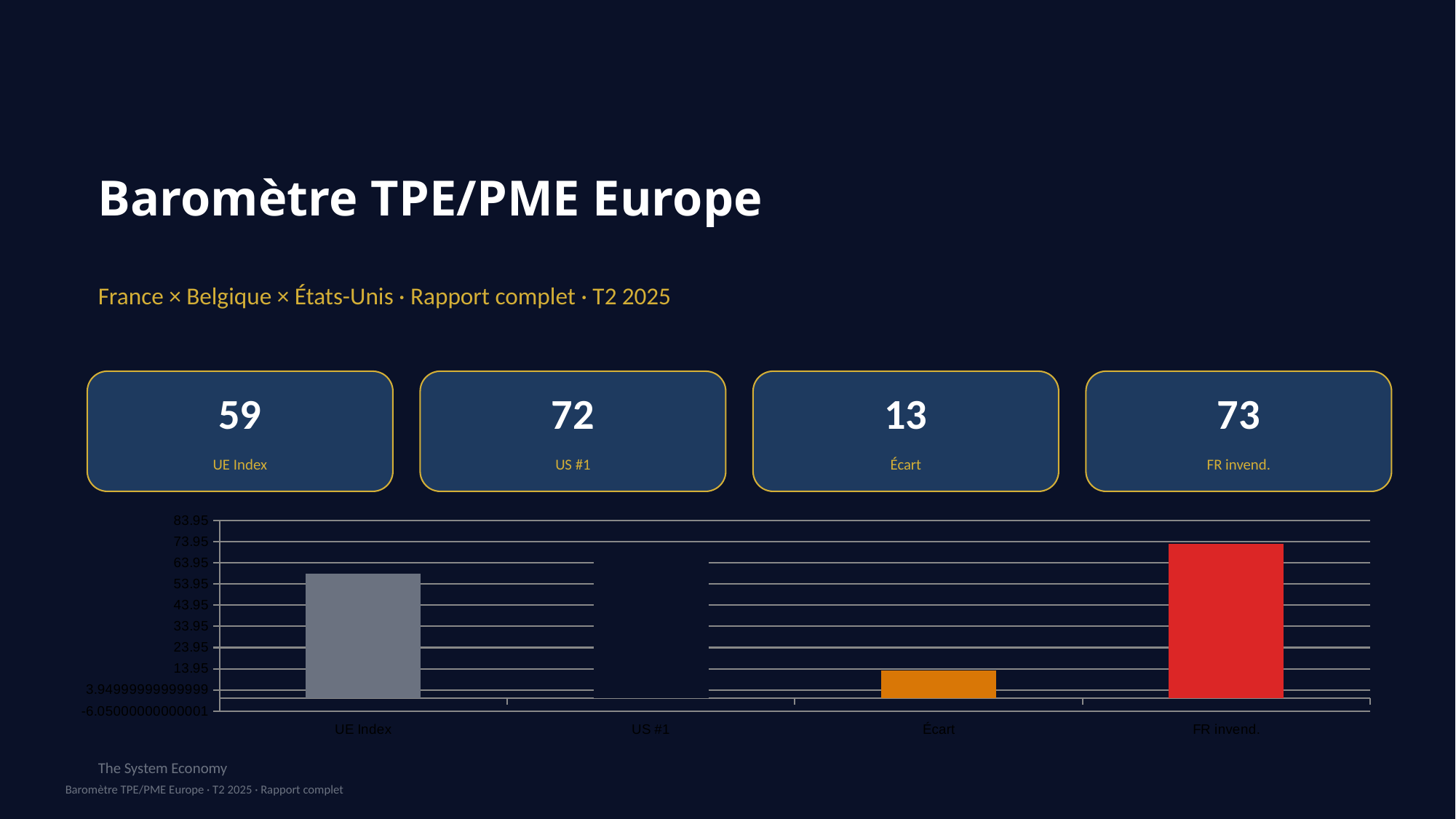
Is the value for Écart greater or less than 23.95? less What kind of chart is shown on the slide? bar chart Which is larger, the value for Écart or the value for UE Index? UE Index What is the value for UE Index? 59 What is the value for Écart? 13 What is the value for FR invend.? 73 Which is larger, the value for UE Index or the value for FR invend.? FR invend. What is the difference between the value for FR invend. and the value for Écart? 60 What is the title of the slide containing the chart? Baromètre TPE/PME Europe Is the value for UE Index greater or less than 53.95? greater How many categories are shown on the x axis of the bar chart? 4 What colour is the bar for FR invend.? red